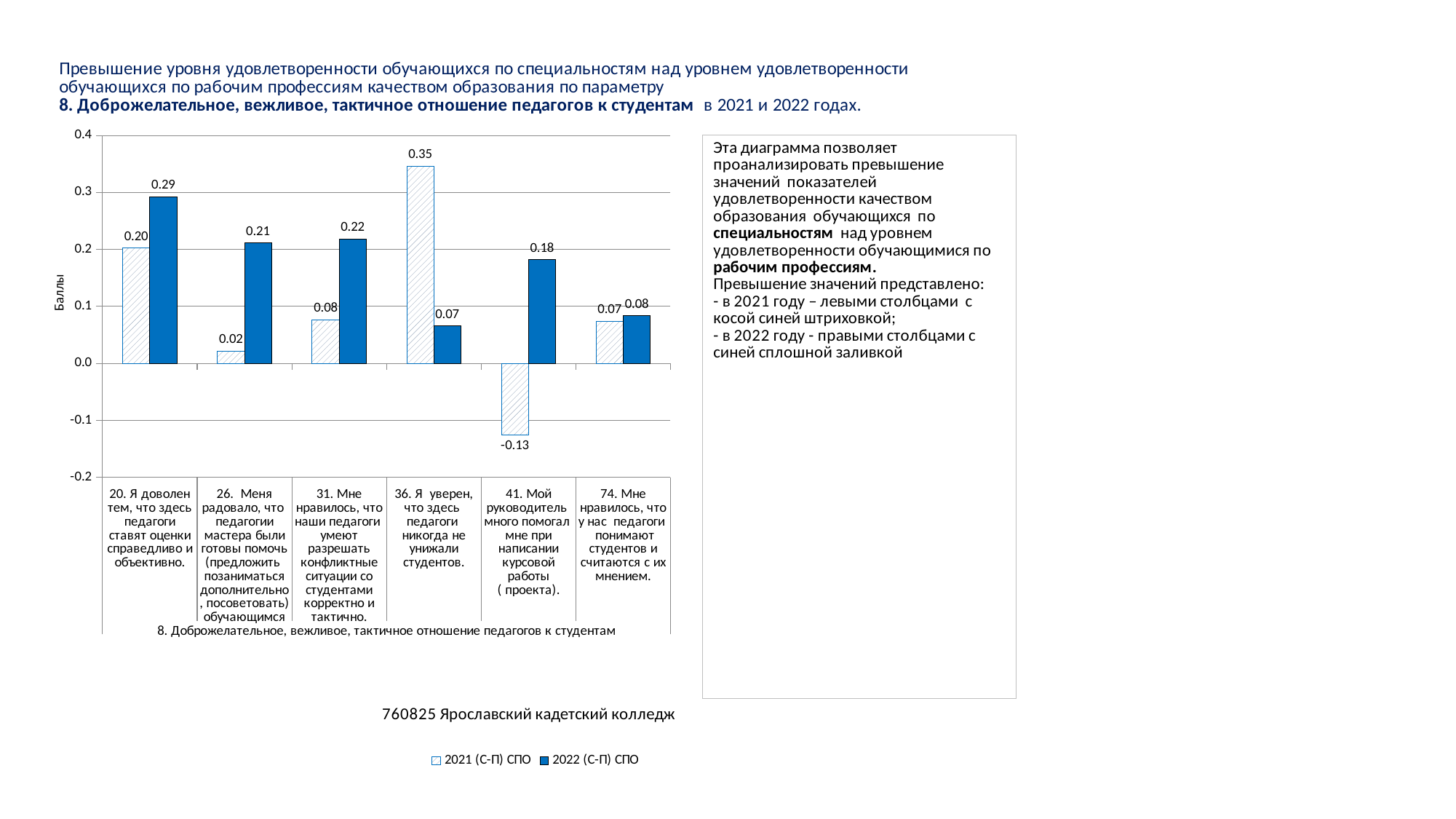
What is the label of the vertical axis of the chart? Баллы Which item has the highest value in the 2022 (С-П) СПО series? 20. Я доволен тем, что здесь педагоги ставят оценки справедливо и объективно. What is the value of the 2021 (С-П) СПО series for item 36 ("Я уверен, что здесь педагоги никогда не унижали студентов")? 0.35 What is the value of the 2021 (С-П) СПО series for item 41 ("Мой руководитель много помогал мне при написании курсовой работы")? -0.13 For item 36 ("Я уверен, что здесь педагоги никогда не унижали студентов"), which series has the larger value, 2021 (С-П) СПО or 2022 (С-П) СПО? 2021 (С-П) СПО What is the value of the 2022 (С-П) СПО series for item 20 ("Я доволен тем, что здесь педагоги ставят оценки справедливо и объективно")? 0.29 What type of chart is shown on the slide? Bar chart How many items (categories) are shown on the x axis of the chart? 6 How many series does the chart legend list? 2 Is the 2022 (С-П) СПО value for item 31 ("Мне нравилось, что наши педагоги умеют разрешать конфликтные ситуации") greater or less than 0.2? greater What is the difference between the 2022 and 2021 values for item 26 ("Меня радовало, что педагоги мастера были готовы помочь")? 0.19 Which item has the lowest value in the 2021 (С-П) СПО series? 41. Мой руководитель много помогал мне при написании курсовой работы (проекта).